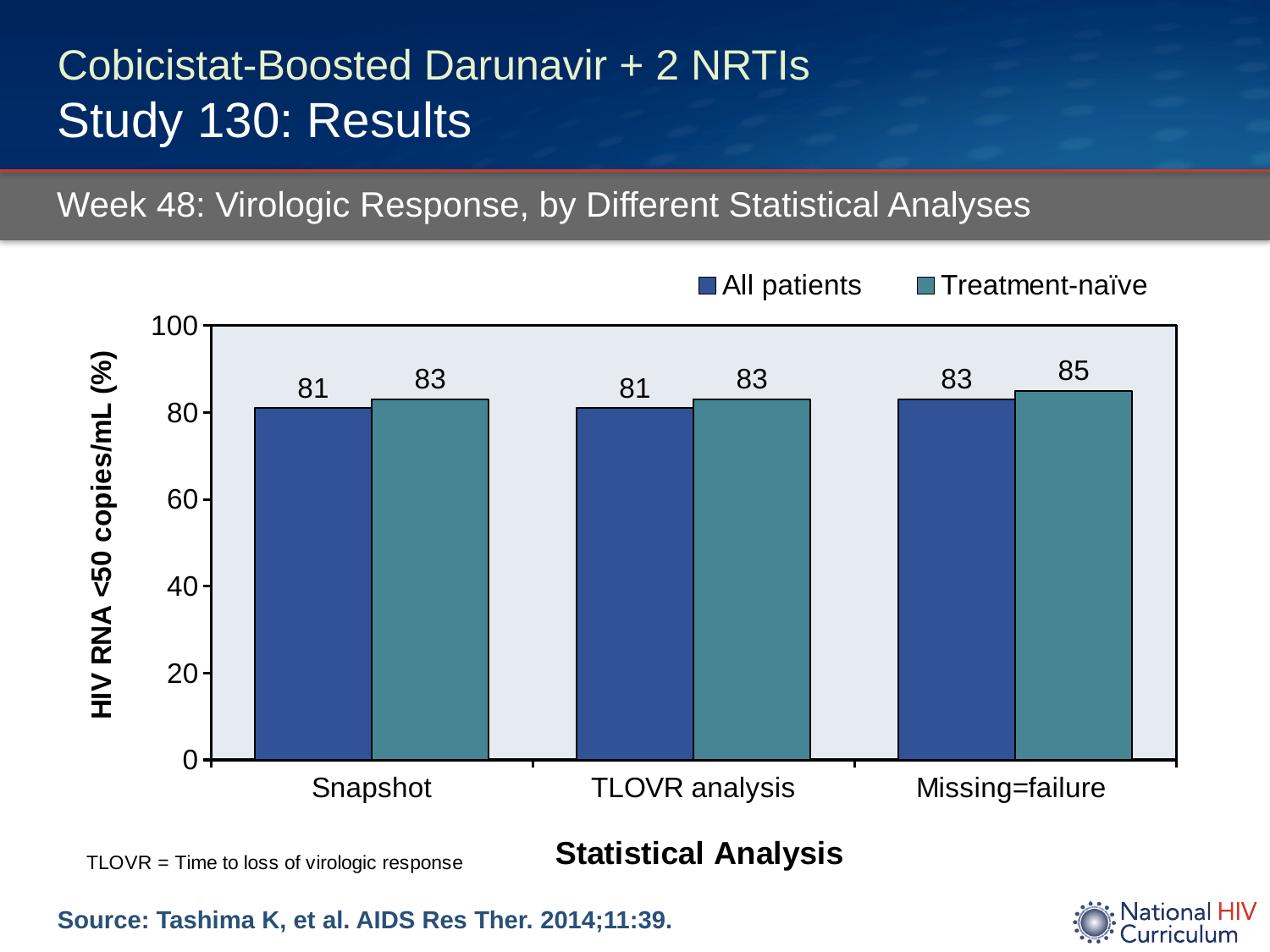
What is the difference between the Treatment-naïve value for Missing=failure and the Treatment-naïve value for Snapshot? 2 What is the value for All patients in the Missing=failure analysis? 83 Which statistical analysis shows the highest value for Treatment-naïve patients? Missing=failure What is the label of the y axis? HIV RNA <50 copies/mL (%) How many statistical analysis categories are shown on the x axis? 3 What is the value for All patients in the Snapshot analysis? 81 What kind of chart is shown on the slide? Bar chart How many series does the legend list? 2 What is the value for Treatment-naïve patients in the Missing=failure analysis? 85 What is the difference between the Treatment-naïve and All patients values in the Snapshot analysis? 2 What is the value for Treatment-naïve patients in the TLOVR analysis? 83 Which is larger in the TLOVR analysis: the value for All patients or for Treatment-naïve? Treatment-naïve